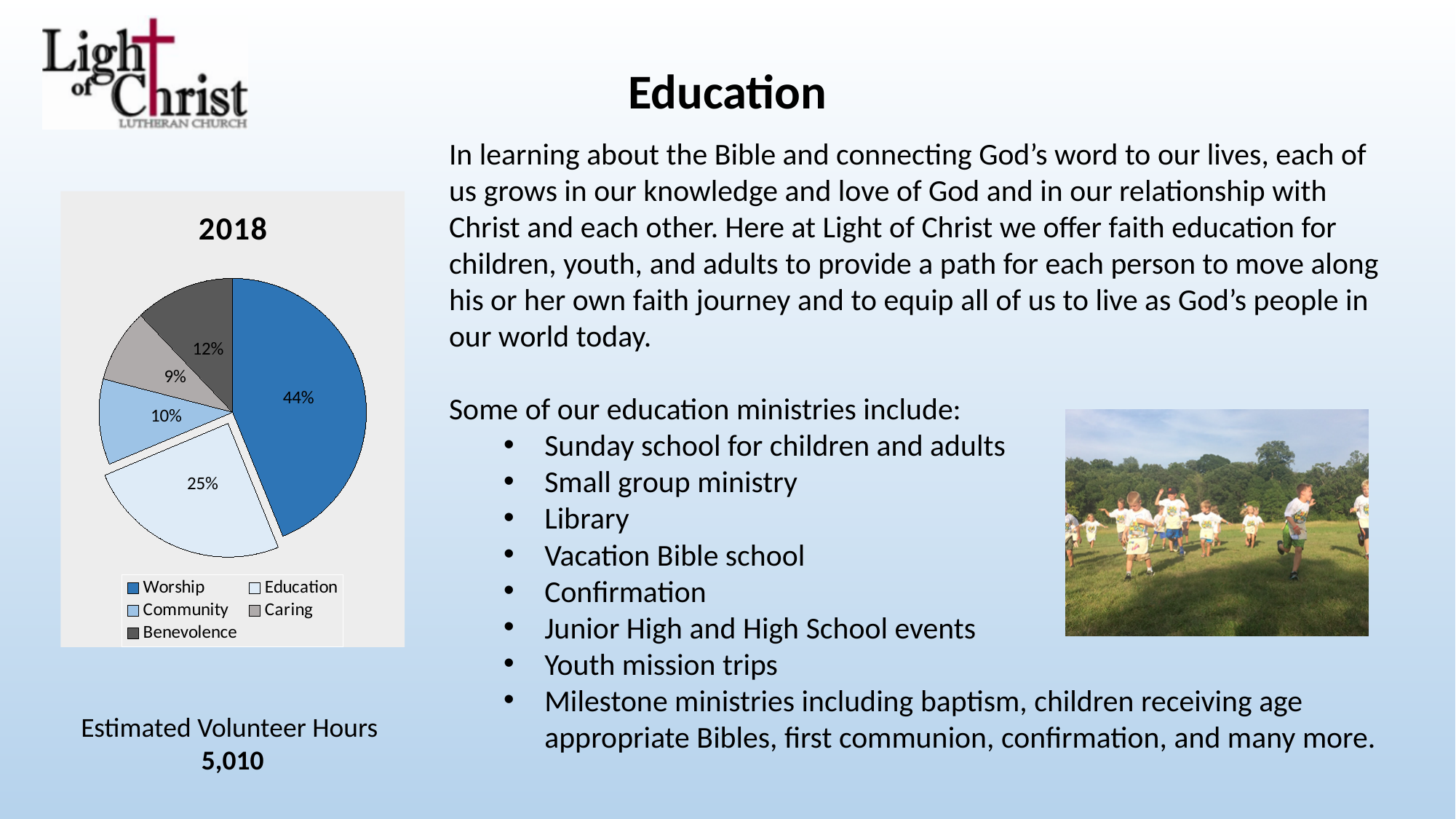
What share of the pie does Education represent? 25% Which slice is larger, Benevolence or Community? Benevolence How many categories does the pie chart show? 5 Which category has the smallest slice of the pie? Caring What share of the pie does Community represent? 10% What share of the pie does Worship represent? 44% What is the title of the pie chart? 2018 What is the difference in percentage points between the Worship and Education slices? 19% What kind of chart is shown on the slide? pie chart Which category has the largest slice of the pie? Worship